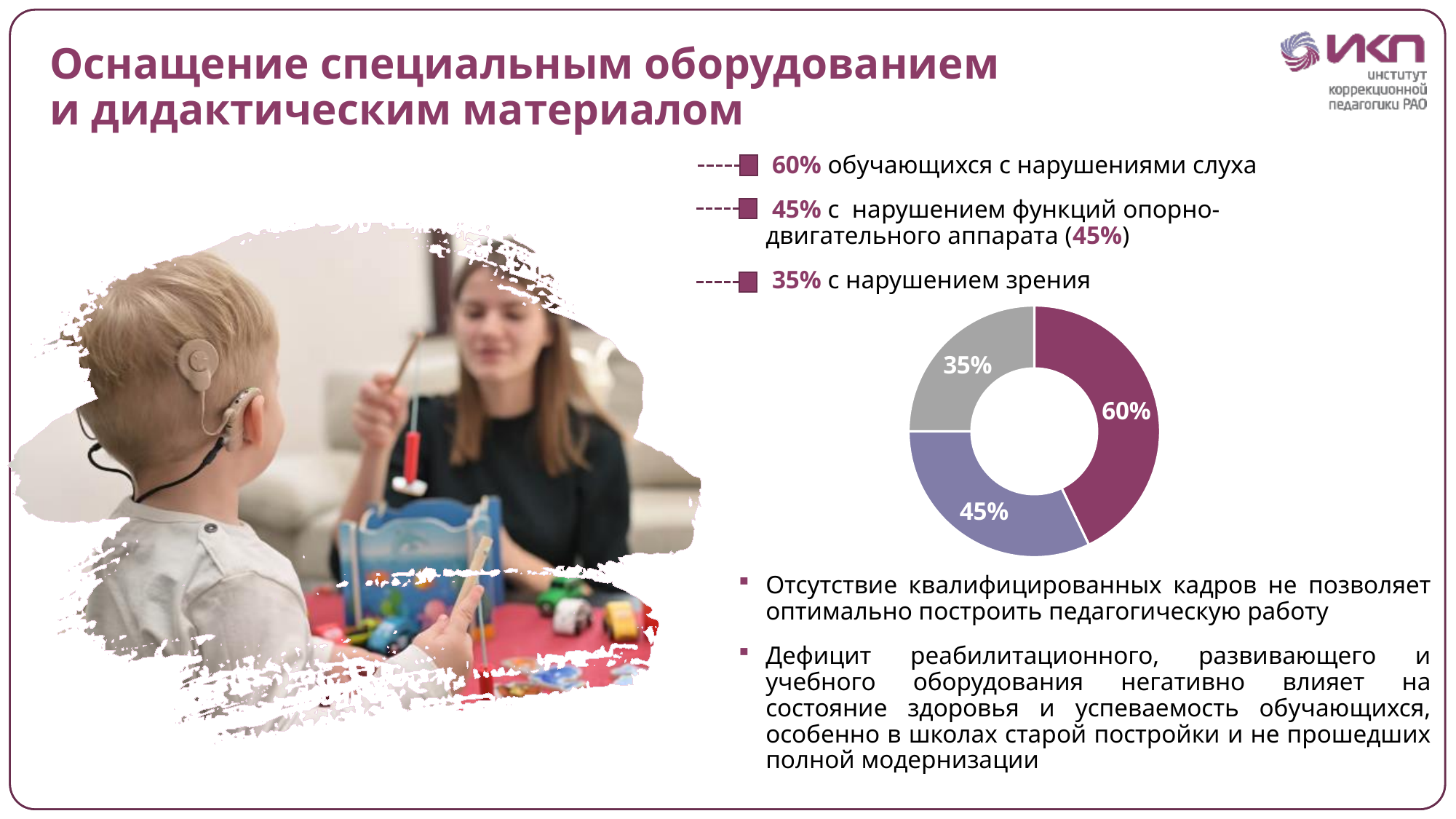
What colour is the slice representing students with hearing impairments (60%)? Dark purple (magenta) Which category has the largest slice in the donut chart? Students with hearing impairments (нарушениями слуха) What is the difference between the hearing impairment value and the visual impairment value? 25% Which category has the smallest slice in the donut chart? Students with visual impairments (нарушением зрения) What percentage is shown for students with musculoskeletal disorders (нарушением функций опорно-двигательного аппарата)? 45% Which is larger: the value for musculoskeletal disorders or the value for visual impairments? Musculoskeletal disorders (45%) What percentage is shown for students with hearing impairments (обучающихся с нарушениями слуха)? 60% What colour is the slice representing students with visual impairments (35%)? Grey What is the difference between the hearing impairment value and the musculoskeletal disorder value? 15% What kind of chart is shown on the slide? Donut (pie) chart How many slices does the donut chart have? 3 What percentage is shown for students with visual impairments (нарушением зрения)? 35%